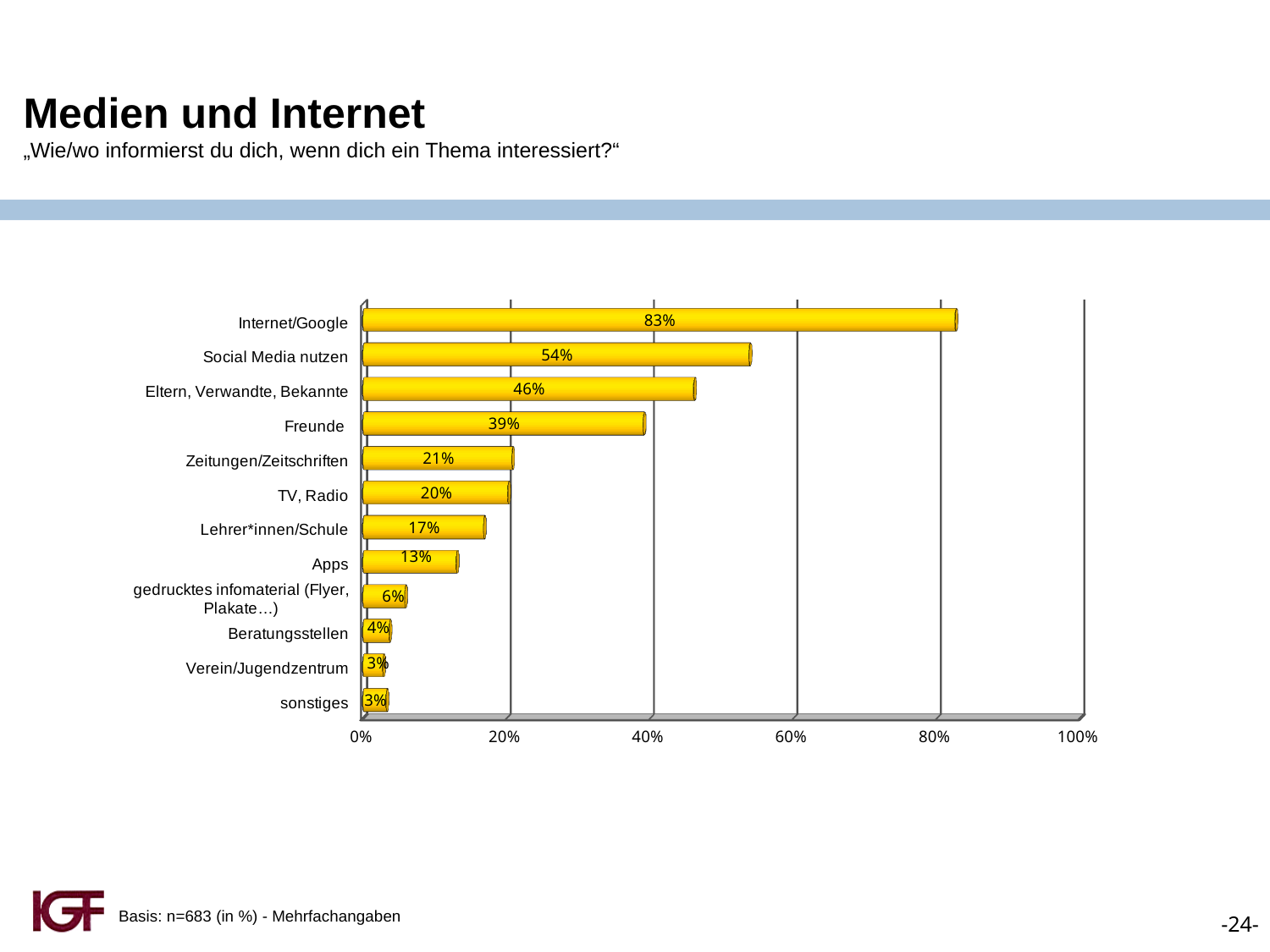
What kind of chart is shown on the slide? bar chart What is the value for Internet/Google? 83% How many categories are shown in the chart? 12 What is the value for Apps? 13% What is the difference between the values for Social Media nutzen and Freunde? 15% What is the title of the slide containing the chart? Medien und Internet Which is larger, the value for Eltern, Verwandte, Bekannte or the value for Freunde? Eltern, Verwandte, Bekannte Which category has the highest value? Internet/Google What is the difference between the values for Zeitungen/Zeitschriften and TV, Radio? 1% What is the value for gedrucktes infomaterial (Flyer, Plakate…)? 6% What is the value for Lehrer*innen/Schule? 17% Is the value for Social Media nutzen greater or less than 40%? greater